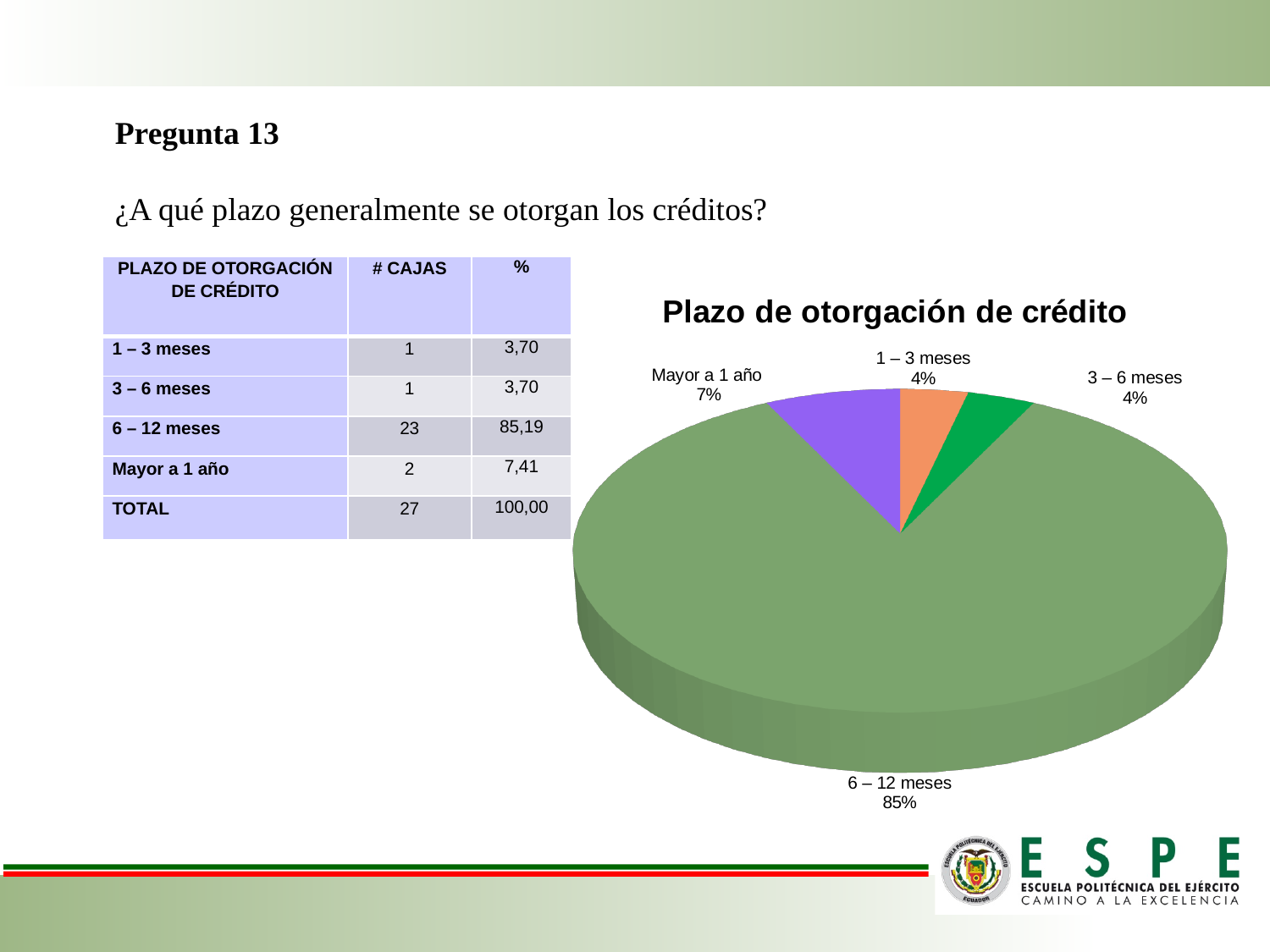
Which is larger, the slice for "Mayor a 1 año" or the slice for "1 – 3 meses"? Mayor a 1 año What kind of chart is shown on the slide? pie chart What is the difference in percentage points between the "6 – 12 meses" slice and the "Mayor a 1 año" slice? 78% What share of the pie does "Mayor a 1 año" represent? 7% What is the title of the chart? Plazo de otorgación de crédito What colour is the "6 – 12 meses" slice? green How many slices does the pie chart have? 4 What share of the pie does "1 – 3 meses" represent? 4% Which category has the largest slice of the pie? 6 – 12 meses What share of the pie does "3 – 6 meses" represent? 4%